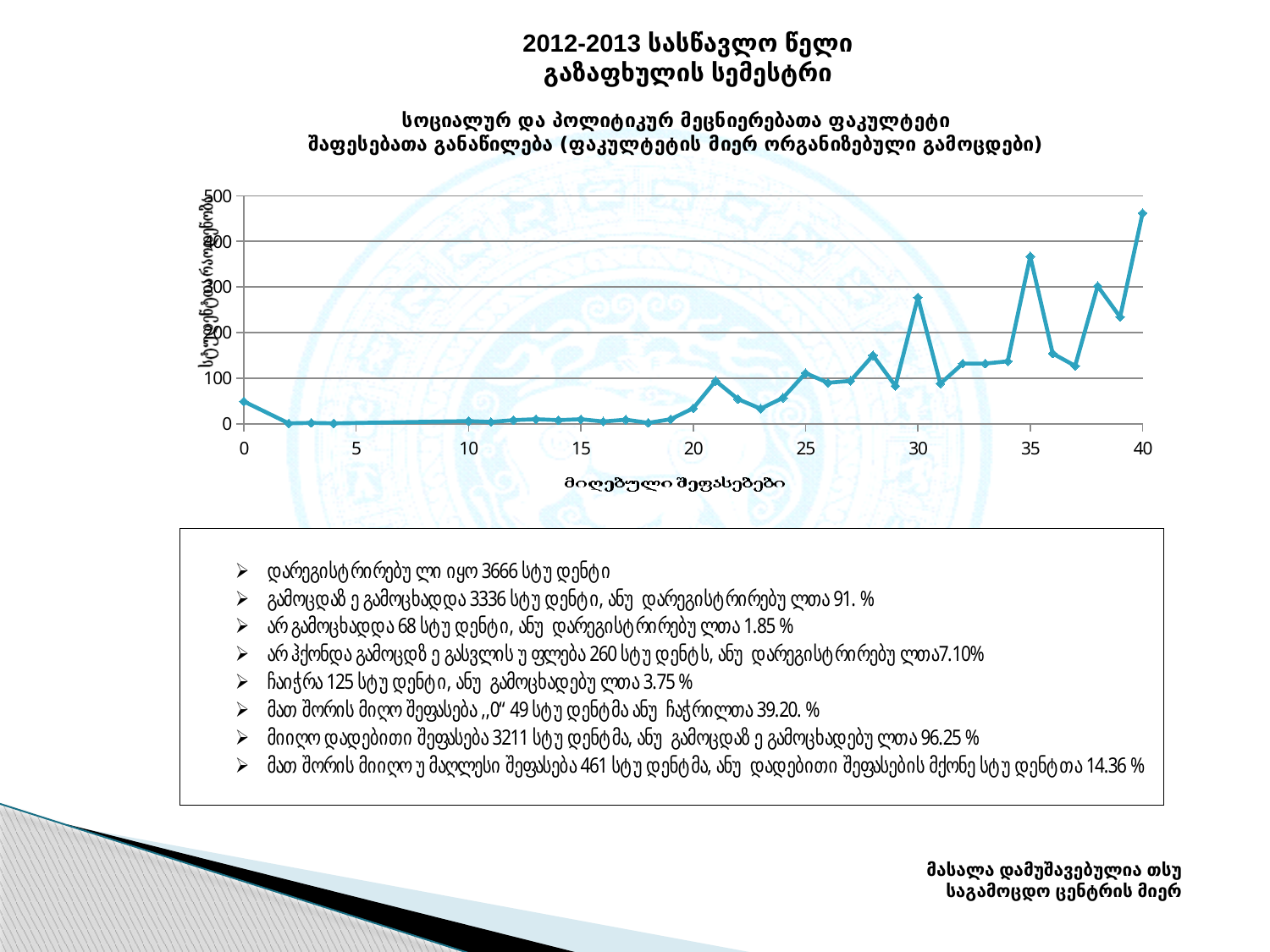
Is the value at x = 20 greater or less than 100? less Overall, do the values rise or fall as the x-axis value increases from 20 to 40? rise Is the value at x = 28 greater or less than 100? greater Is the value at x = 35 greater or less than 300? greater At which x-axis value (score) does the line reach its highest point? 40 What is the label of the x axis? მიღებული შეფასებები Which has the larger value, x = 40 or x = 35? 40 What kind of chart is shown on the slide? line chart Which has the larger value, x = 35 or x = 30? 35